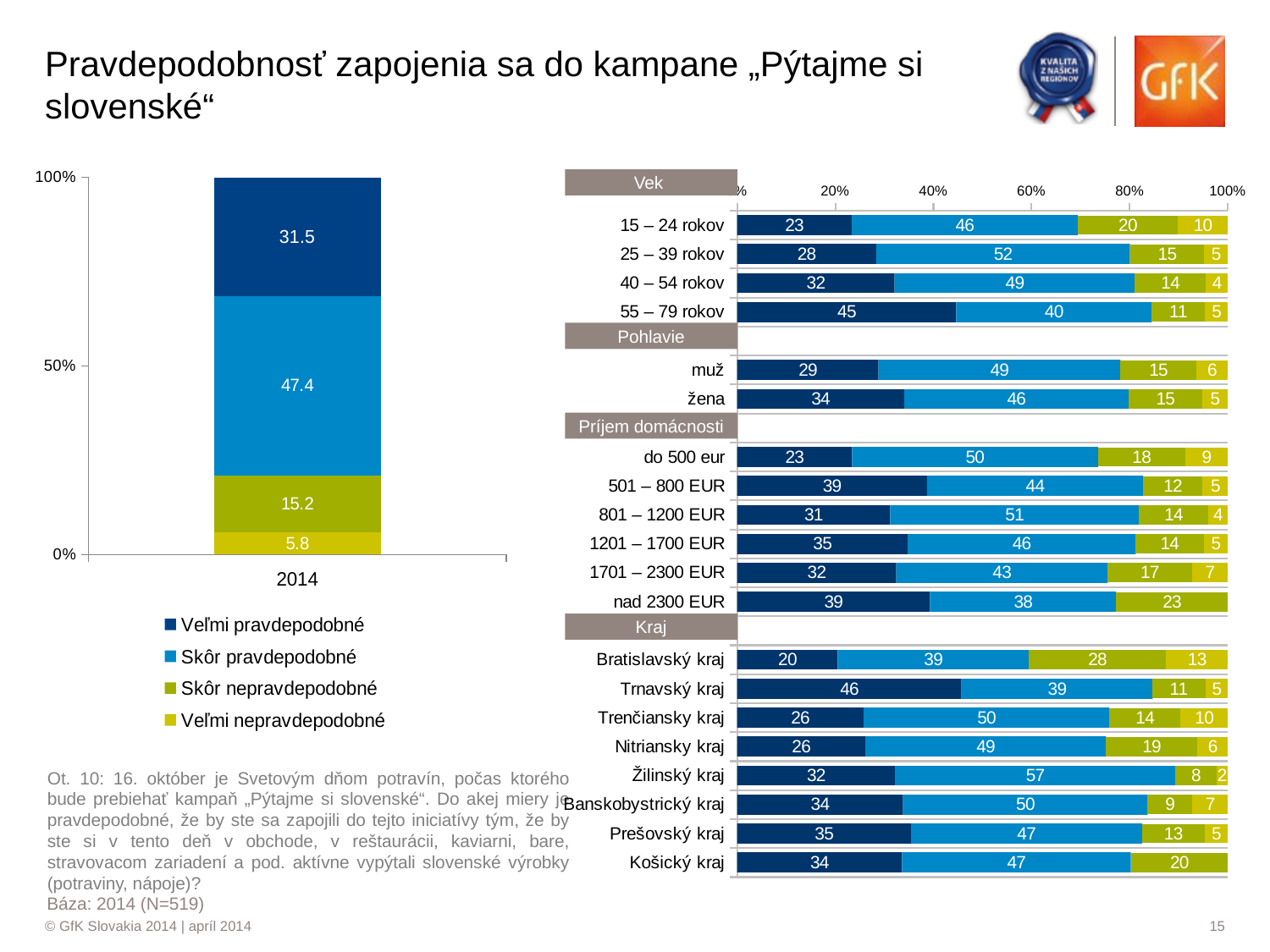
What kind of chart is the left chart? Stacked bar chart On the right chart, what is the value of the dark blue segment for 55 – 79 rokov? 45 On the right chart, what is the value of the light blue segment for Žilinský kraj? 57 On the left chart, what is the difference between Skôr pravdepodobné and Veľmi pravdepodobné? 15.9 On the right chart, which kraj has the lowest dark blue segment? Bratislavský kraj On the left chart, what is the value for Skôr nepravdepodobné in 2014? 15.2 On the left chart, what is the value for Veľmi pravdepodobné in 2014? 31.5 On the right chart, which age group has the highest dark blue segment? 55 – 79 rokov How many series does the legend of the left chart list? 4 On the right chart, how many kraj categories are shown? 8 On the right chart, what is the difference between the dark blue segments for žena and muž? 5 On the left chart, which category has the lowest value? Veľmi nepravdepodobné